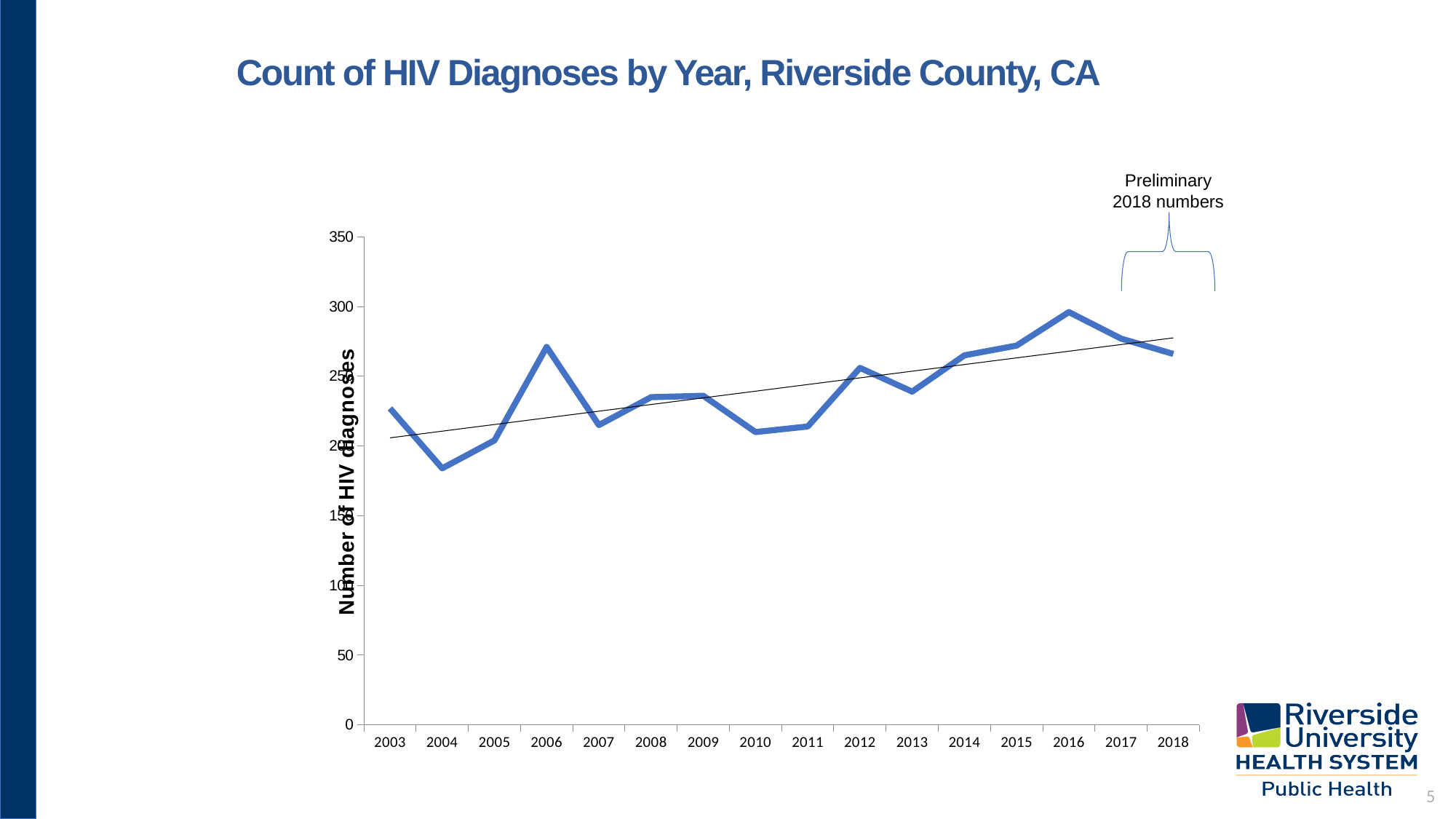
Which year has a higher count of HIV diagnoses, 2006 or 2007? 2006 What is the label on the vertical axis of the chart? Number of HIV diagnoses Which year has the highest count of HIV diagnoses? 2016 Which year has a higher count of HIV diagnoses, 2016 or 2018? 2016 What type of chart is shown on the slide? line chart Which year has the lowest count of HIV diagnoses? 2004 Is the value for 2004 greater or less than 200? less How many years are plotted along the x axis? 16 Is the value for 2003 greater or less than 200? greater Is the value for 2007 greater or less than 250? less Does the overall trend of HIV diagnoses from 2003 to 2018 rise or fall? rise